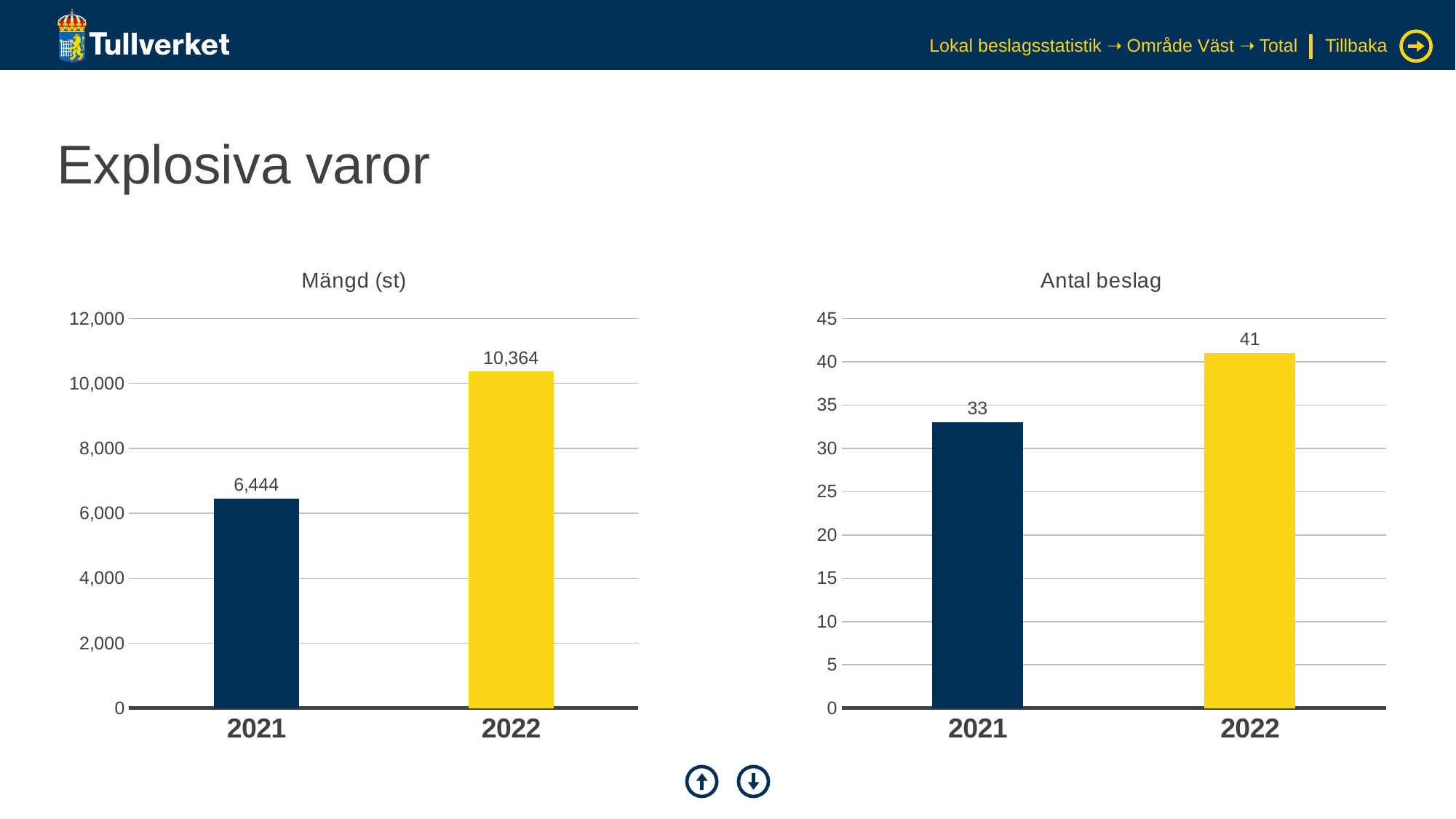
In the 'Mängd (st)' chart, do the values rise or fall from 2021 to 2022? Rise In the 'Mängd (st)' chart, what is the difference between the 2022 and 2021 values? 3,920 In the 'Mängd (st)' chart, what is the value for 2021? 6,444 In the 'Antal beslag' chart, what is the difference between the 2022 and 2021 values? 8 In the 'Antal beslag' chart, is the value for 2022 greater or less than 40? greater In the 'Mängd (st)' chart, what is the value for 2022? 10,364 In the 'Antal beslag' chart, which year has the lowest value? 2021 In the 'Antal beslag' chart, what is the value for 2022? 41 In the 'Antal beslag' chart, what is the value for 2021? 33 What kind of chart is the 'Antal beslag' chart? Bar chart How many categories are shown on the x axis of the 'Mängd (st)' chart? 2 In the 'Mängd (st)' chart, which year has the highest value? 2022